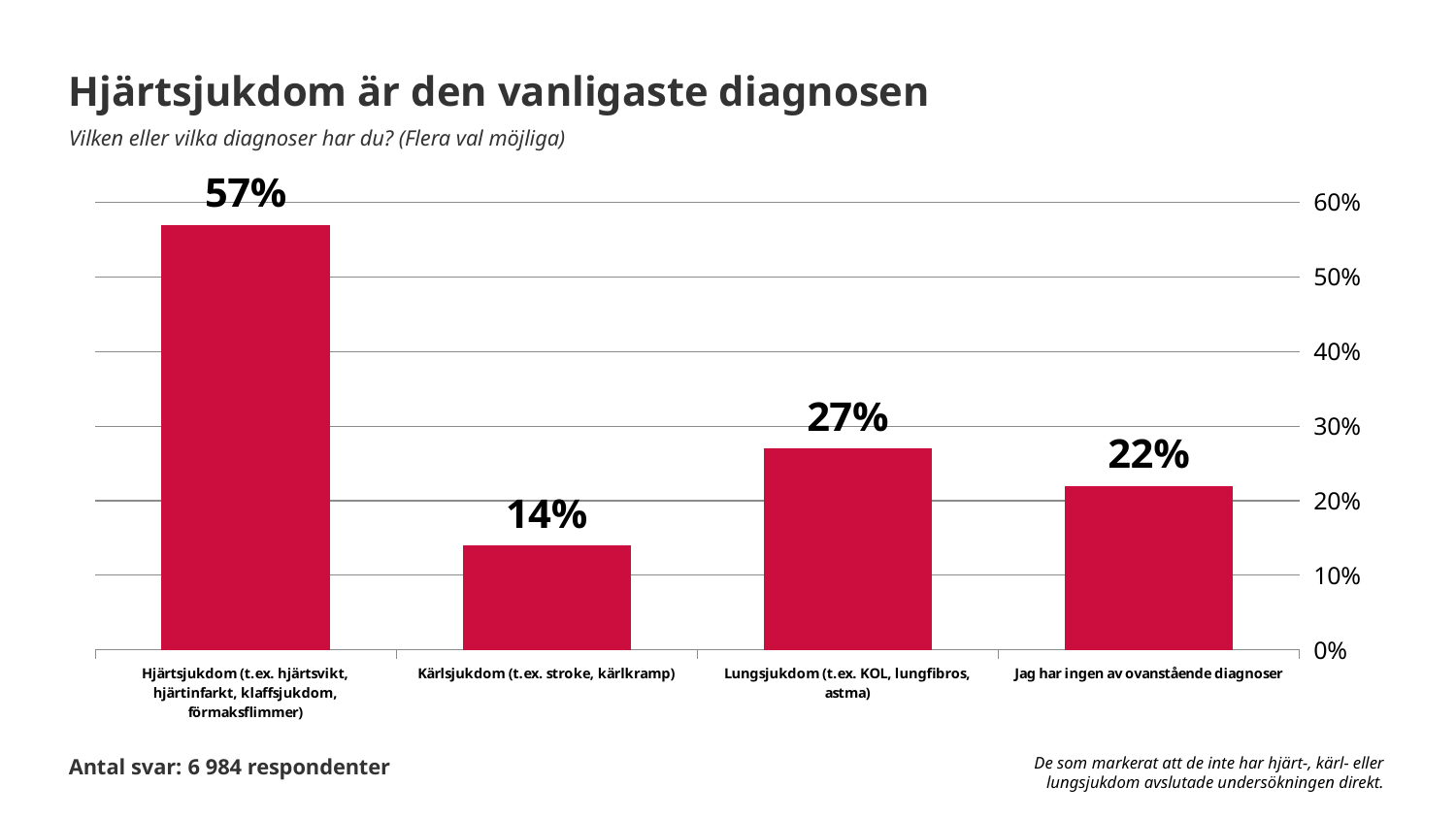
What is the value for Lungsjukdom (t.ex. KOL, lungfibros, astma)? 27% How many respondents answered the survey, according to the slide? 6 984 respondenter Which diagnosis category has the highest value? Hjärtsjukdom (t.ex. hjärtsvikt, hjärtinfarkt, klaffsjukdom, förmaksflimmer) What is the difference between the value for Lungsjukdom and the value for Kärlsjukdom? 13% What kind of chart is shown on the slide? Bar chart How many categories are shown in the chart? 4 Which is larger: the value for Lungsjukdom or the value for 'Jag har ingen av ovanstående diagnoser'? Lungsjukdom What is the value for Kärlsjukdom (t.ex. stroke, kärlkramp)? 14% What percentage of respondents chose 'Jag har ingen av ovanstående diagnoser'? 22% Which category has the lowest value? Kärlsjukdom (t.ex. stroke, kärlkramp) What is the difference between the value for Hjärtsjukdom and the value for Lungsjukdom? 30% What percentage of respondents reported Hjärtsjukdom (t.ex. hjärtsvikt, hjärtinfarkt, klaffsjukdom, förmaksflimmer)? 57%